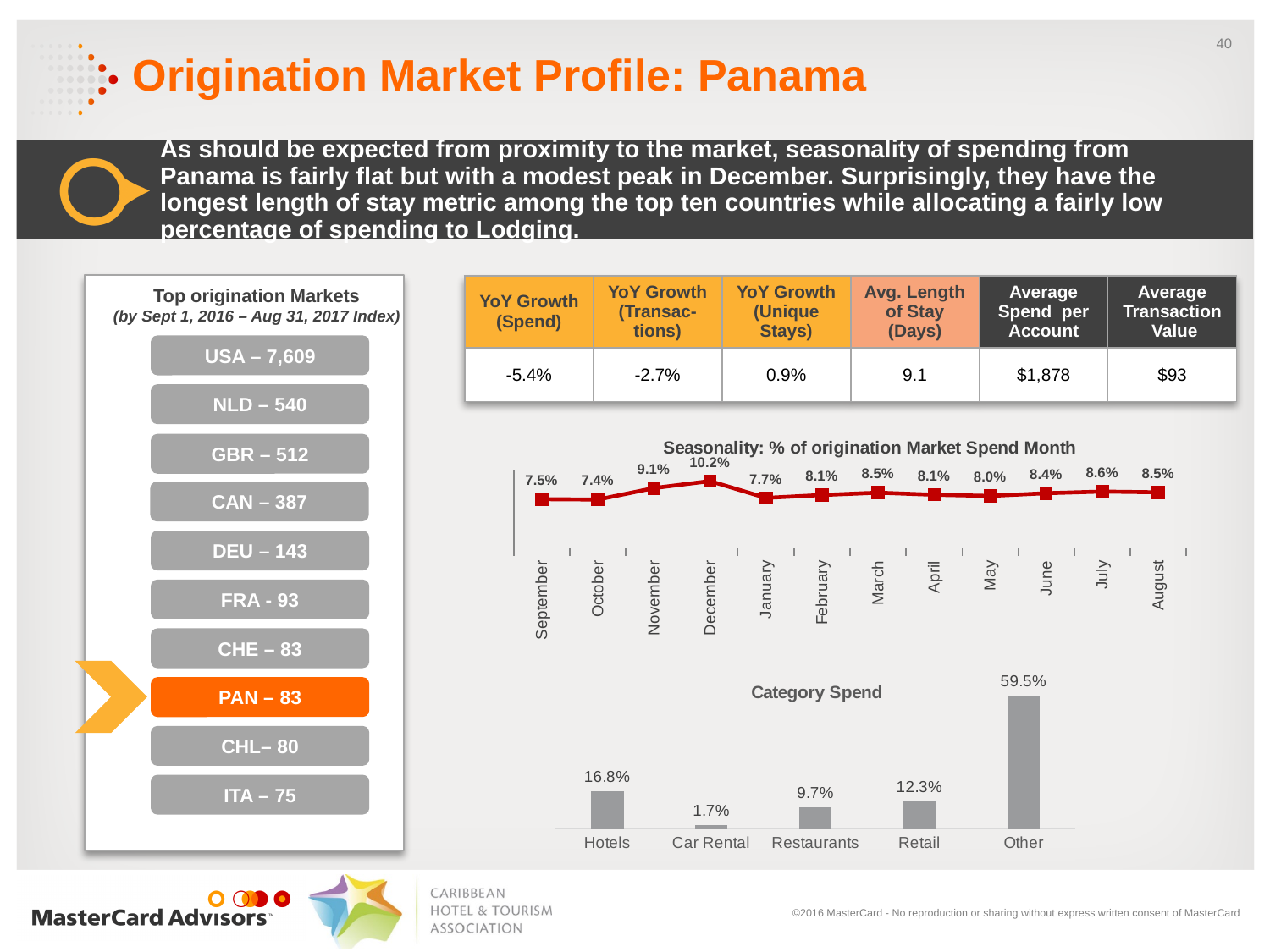
What type of chart is the Seasonality chart? Line chart In the Seasonality chart, which month has the highest value? December In the Seasonality chart, is the value for July larger or smaller than the value for January? Larger In the Seasonality chart, what is the value for December? 10.2% In the Category Spend chart, what is the difference between Hotels and Restaurants? 7.1% In the Category Spend chart, which category has the highest value? Other In the Seasonality chart, what is the difference between the December and November values? 1.1% In the Category Spend chart, what is the value for Retail? 12.3% In the Seasonality chart, which month has the lowest value? October In the Seasonality chart, how many months are plotted? 12 What type of chart is the Category Spend chart? Bar chart In the Category Spend chart, which category has the lowest value? Car Rental